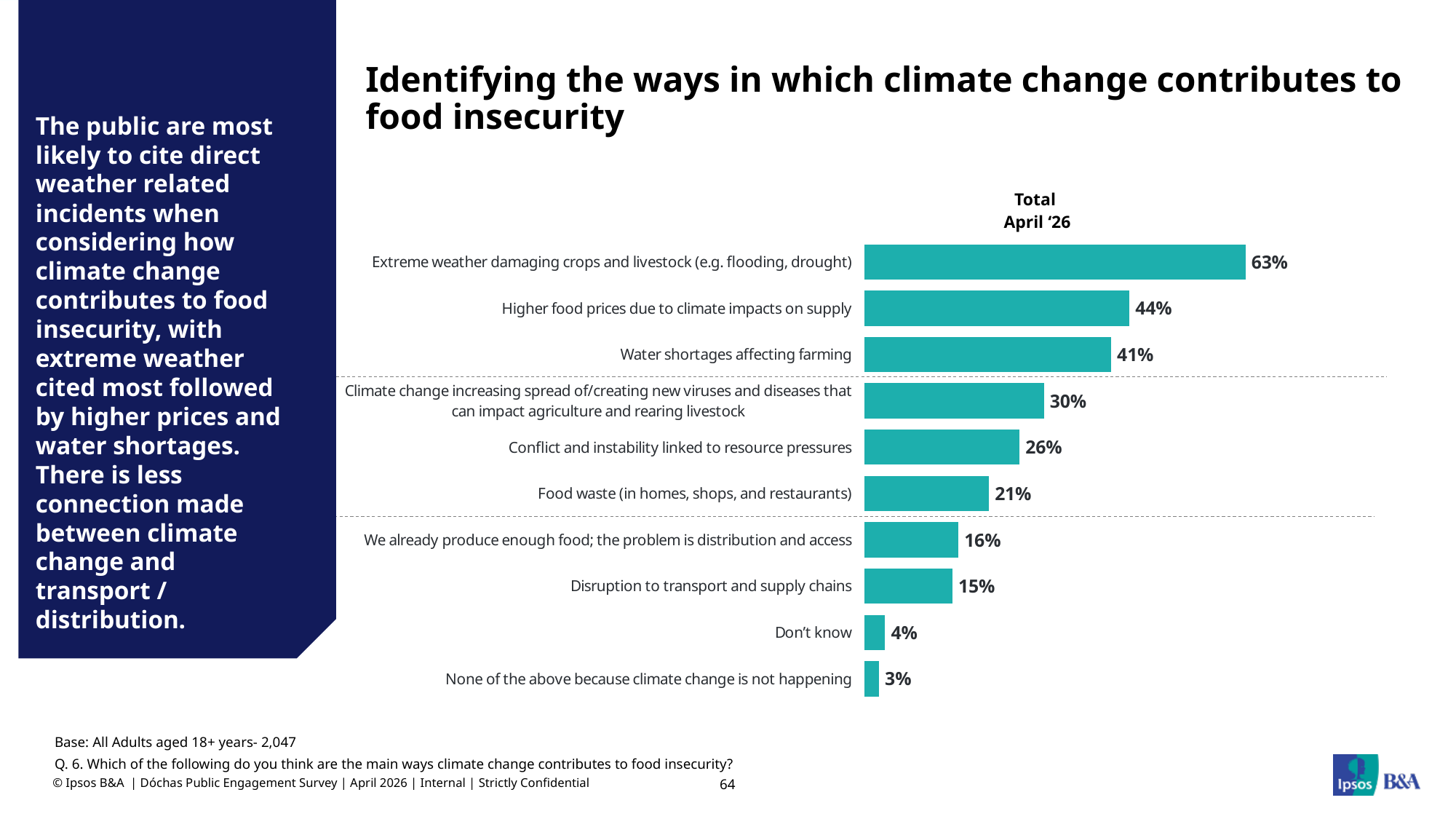
What is the column header shown above the bars? Total April '26 What kind of chart is shown on the slide? Bar chart What is the difference between 'Higher food prices due to climate impacts on supply' and 'Water shortages affecting farming'? 3% How many categories are shown in the chart? 10 What is the difference between 'Extreme weather damaging crops and livestock' and 'Food waste (in homes, shops, and restaurants)'? 42% What is the value for 'Don't know'? 4% What percentage cited 'Disruption to transport and supply chains'? 15% Which category has the highest value? Extreme weather damaging crops and livestock (e.g. flooding, drought) Which is larger: 'Conflict and instability linked to resource pressures' or 'Food waste (in homes, shops, and restaurants)'? Conflict and instability linked to resource pressures What percentage cited 'Extreme weather damaging crops and livestock (e.g. flooding, drought)'? 63% What is the value for 'Water shortages affecting farming'? 41% Which category has the lowest value? None of the above because climate change is not happening